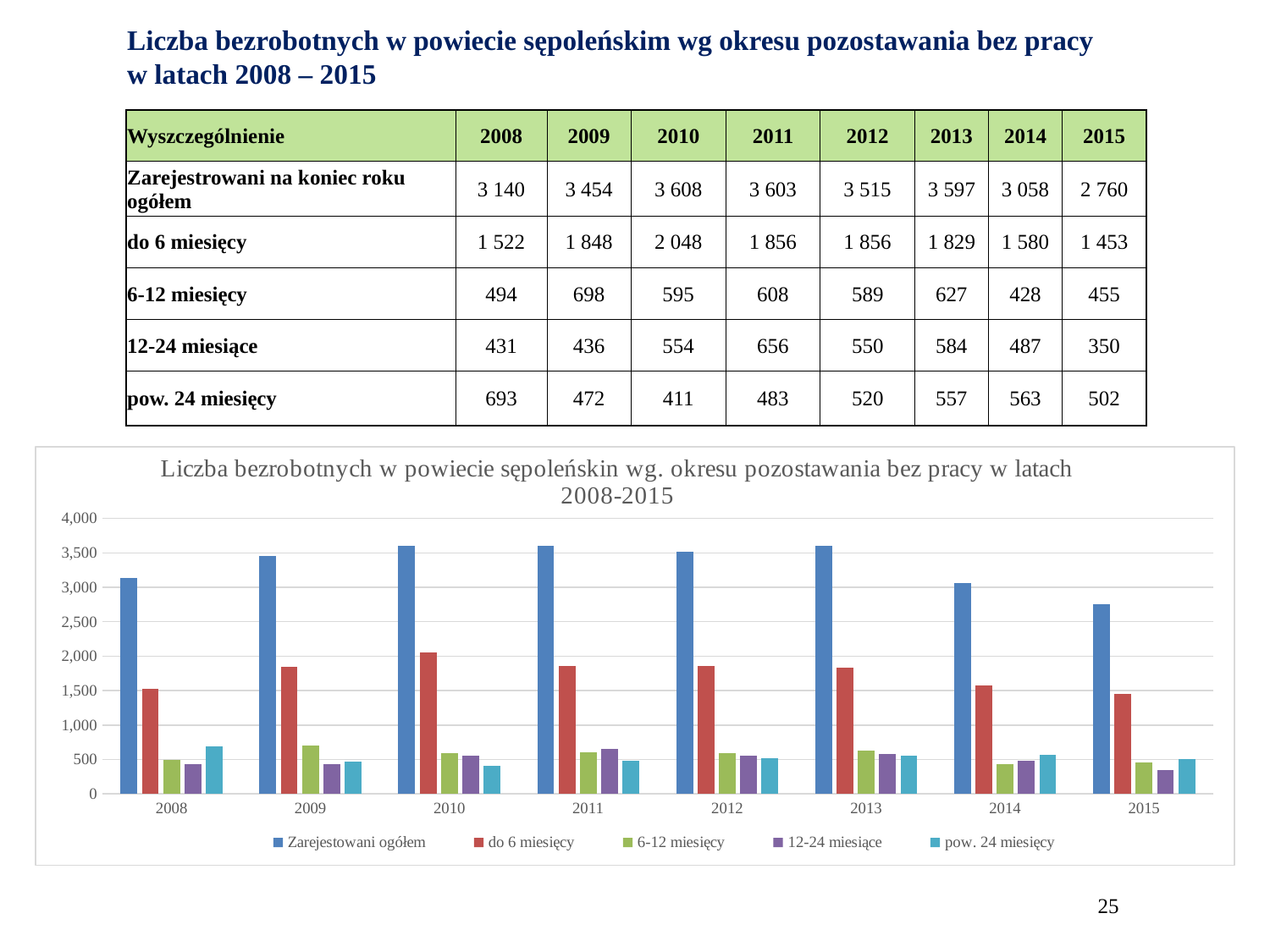
What colour are the bars for Zarejestrowani ogółem in the chart? blue Is the value for Zarejestrowani ogółem in 2015 greater or less than 3,000? less What is the value for do 6 miesięcy in 2010? 2 048 What is the difference between Zarejestrowani ogółem in 2008 and in 2015? 380 What is the value for pow. 24 miesięcy in 2008? 693 What type of chart is shown on the slide? bar chart Is the value for do 6 miesięcy in 2009 greater or less than 2,000? less In which year is the value for Zarejestrowani ogółem the lowest? 2015 In 2009, which is larger: 6-12 miesięcy or 12-24 miesiące? 6-12 miesięcy How many years are shown along the x axis of the chart? 8 How many series does the chart legend list? 5 Does the value for Zarejestrowani ogółem rise or fall from 2013 to 2015? fall